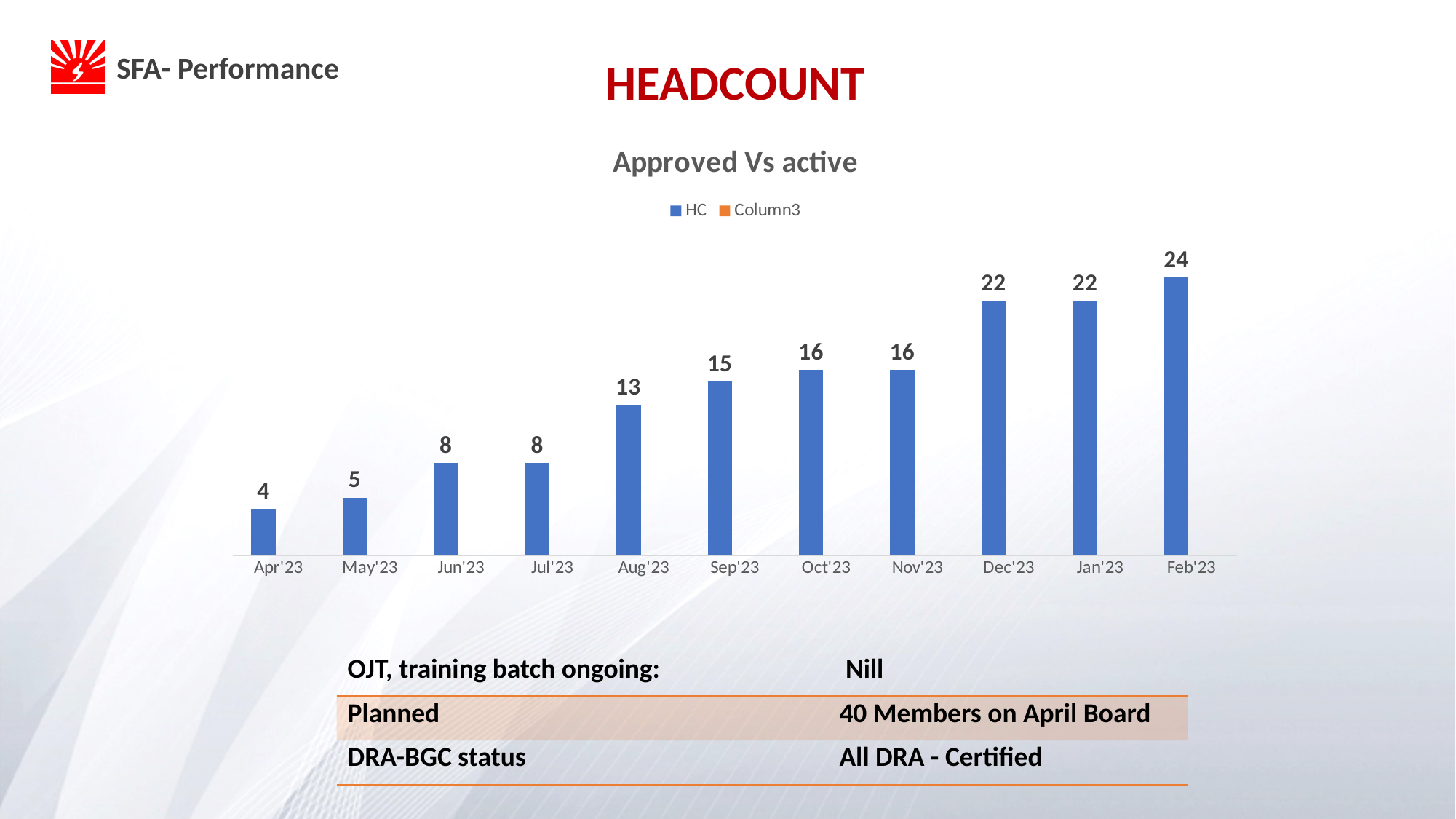
What is the difference between the HC values for Feb'23 and Apr'23? 20 What is the HC value for Dec'23? 22 What is the difference between the HC values for Sep'23 and Jul'23? 7 Which month has the lowest HC value? Apr'23 How many series does the legend list? 2 Which month has the highest HC value? Feb'23 Which is larger, the HC value for Oct'23 or the HC value for Jun'23? Oct'23 What is the HC value for Aug'23? 13 What kind of chart is shown on the slide? Bar chart What is the HC value for Apr'23? 4 Do the HC values generally rise or fall from Apr'23 to Feb'23? Rise How many months are shown on the x axis of the chart? 11